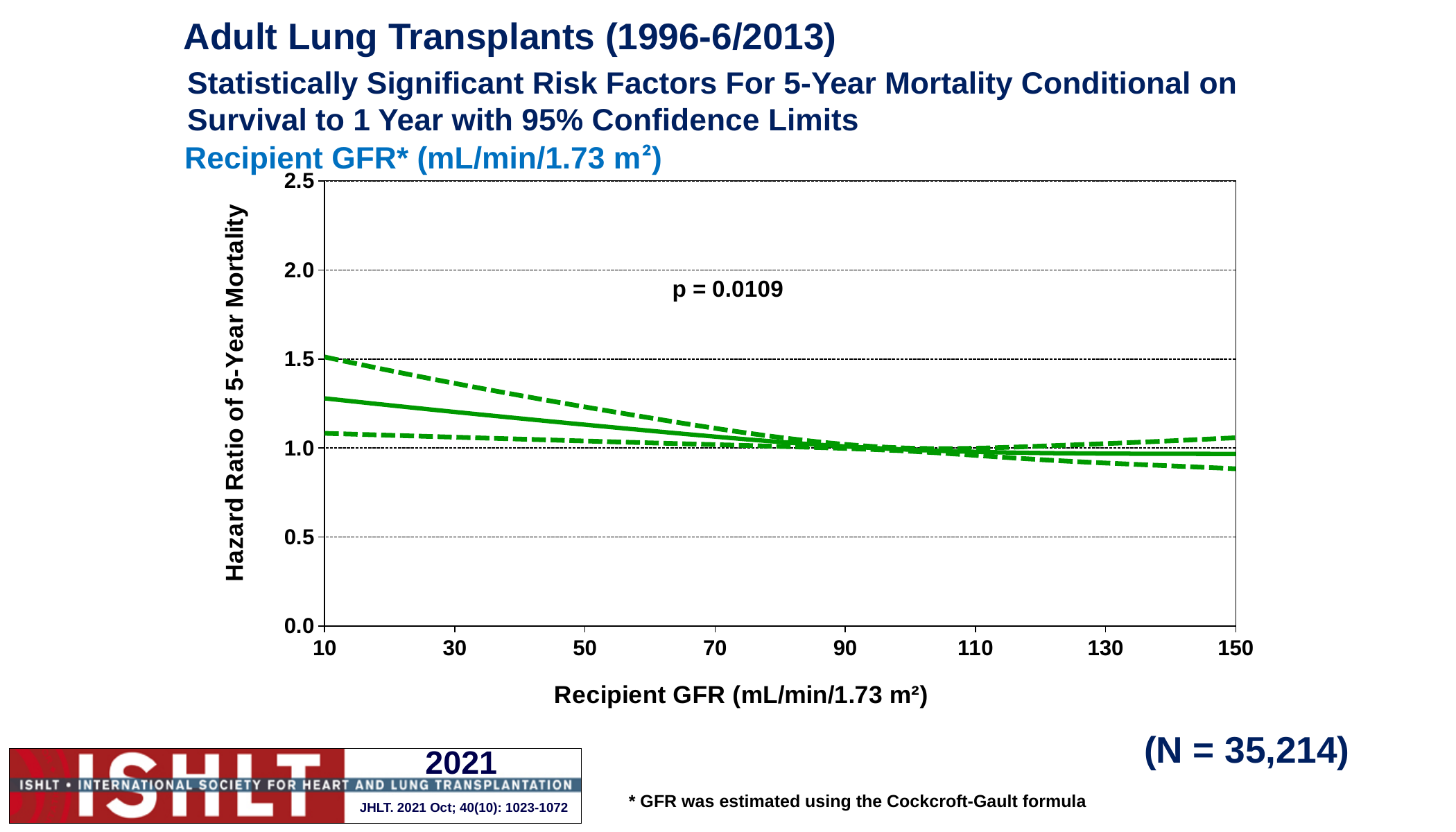
Is the hazard ratio on the solid line at a recipient GFR of 10 greater or less than 1.5? less What p-value is printed on the chart? p = 0.0109 Does the solid hazard ratio line rise or fall as recipient GFR increases from 10 to 150? fall What kind of chart is shown on the slide? line chart Is the lower dashed confidence limit at a recipient GFR of 150 greater or less than 1.0? less What is the label of the y axis? Hazard Ratio of 5-Year Mortality Is the hazard ratio on the solid line at a recipient GFR of 50 greater or less than 1.0? greater What is the sample size (N) shown on the slide? N = 35,214 What is the highest value shown on the y axis? 2.5 How many lines are plotted on the chart? 3